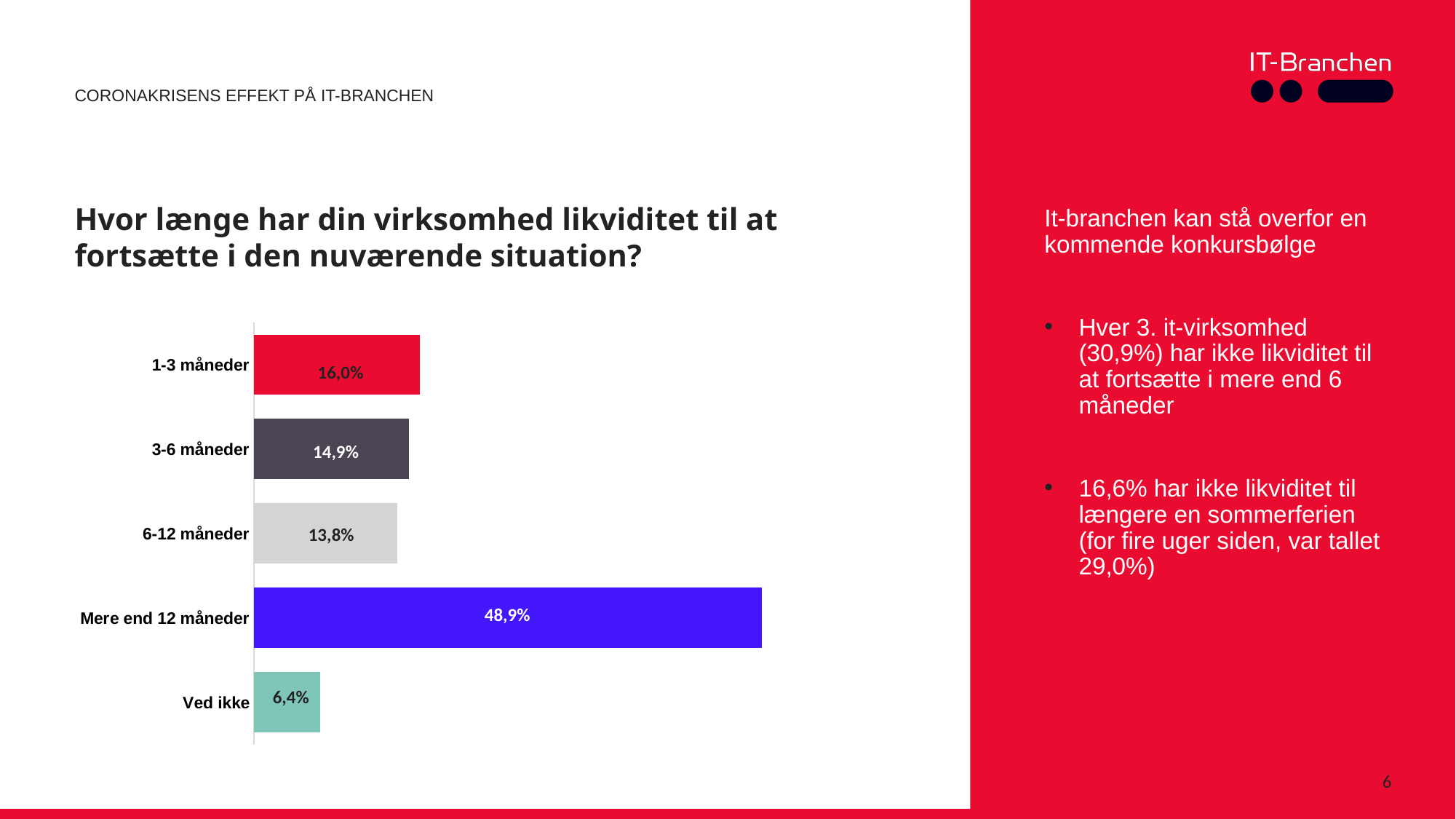
What is the combined value of "1-3 måneder" and "3-6 måneder"? 30,9% What is the value for "Ved ikke"? 6,4% What kind of chart is shown on the slide? Bar chart Which category has the lowest value? Ved ikke How many categories are shown in the chart? 5 Which category has the highest value? Mere end 12 måneder What is the value for "6-12 måneder"? 13,8% What is the value for "Mere end 12 måneder"? 48,9% What is the value for "1-3 måneder"? 16,0% What is the difference between the values for "1-3 måneder" and "3-6 måneder"? 1,1% What colour is the bar for "Mere end 12 måneder"? Blue Which is larger, the value for "3-6 måneder" or the value for "6-12 måneder"? 3-6 måneder